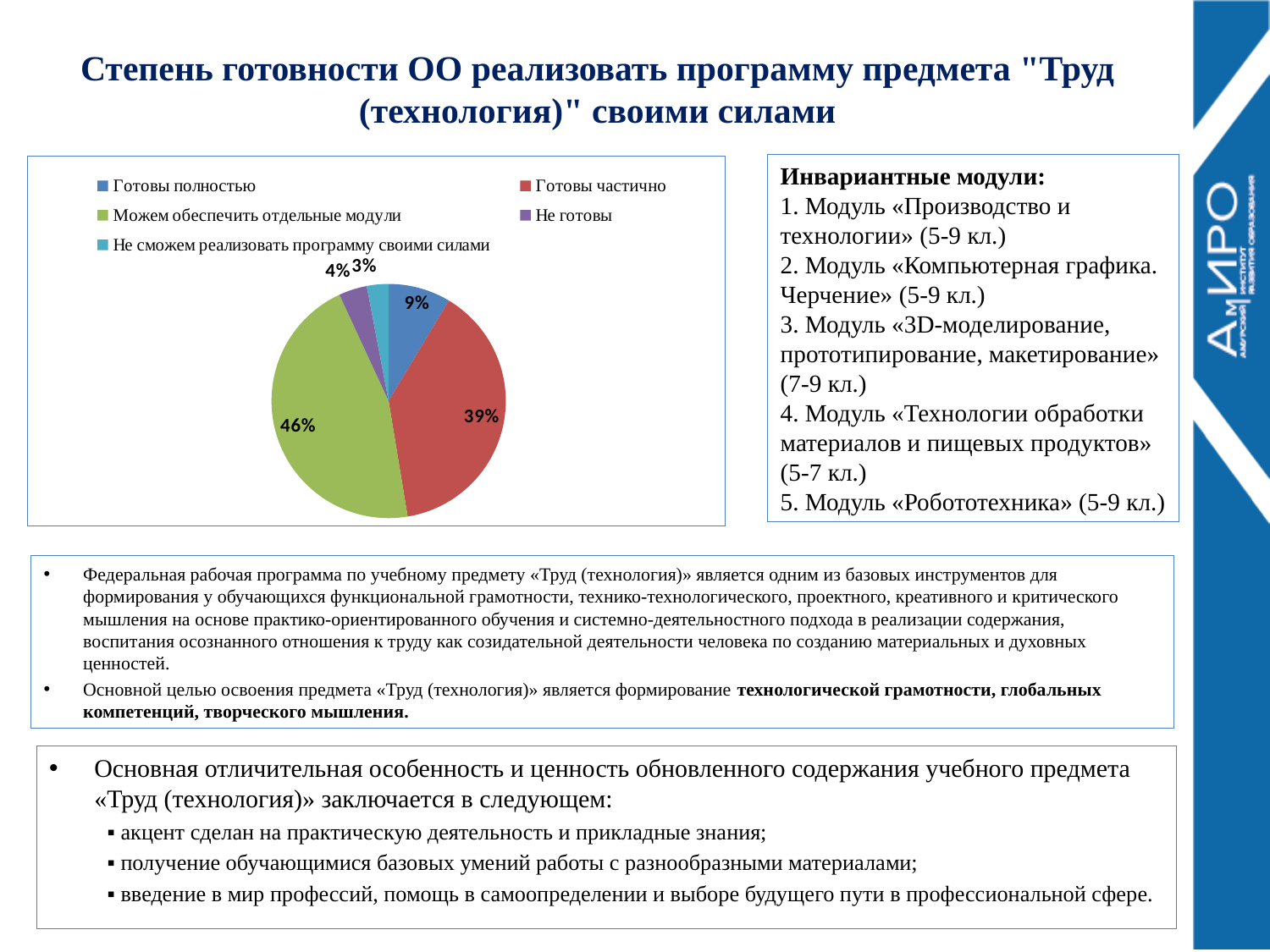
Which category has the largest slice of the pie? Можем обеспечить отдельные модули What share of the pie is labelled "Готовы частично"? 39% What is the difference in percentage points between "Можем обеспечить отдельные модули" and "Готовы частично"? 7 How many categories does the pie chart legend list? 5 What colour is the slice for "Готовы частично"? Red What share of the pie is labelled "Не готовы"? 4% What share of the pie is labelled "Готовы полностью"? 9% Which category has the smallest slice of the pie? Не сможем реализовать программу своими силами What share of the pie is labelled "Не сможем реализовать программу своими силами"? 3% Which is larger: the slice for "Готовы полностью" or the slice for "Не готовы"? Готовы полностью What share of the pie is labelled "Можем обеспечить отдельные модули"? 46% What kind of chart is shown on the slide? Pie chart